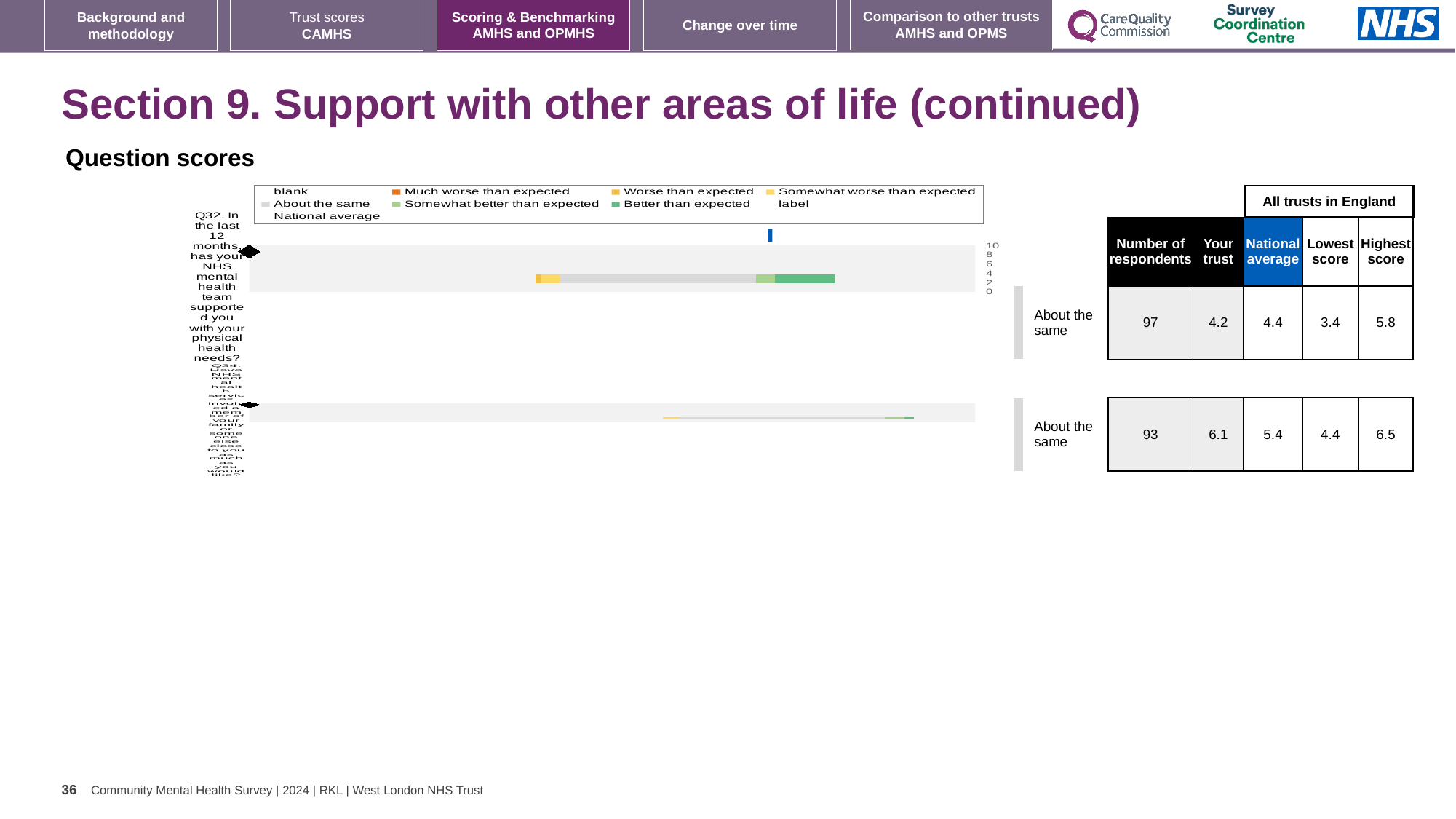
How many questions (categories) are plotted in the question scores chart? 2 What is the national average score for Q34 in the table beside the chart? 5.4 How many respondents answered Q32 according to the table beside the chart? 97 How many entries does the legend of the question scores chart list? 9 What is the 'Your trust' score for Q32 in the table beside the chart? 4.2 What is the highest score among all trusts in England for Q34? 6.5 In the question scores chart legend, what colour represents 'Better than expected'? green For Q34, which is larger: the 'Your trust' score or the national average? Your trust What is the lowest score among all trusts in England for Q32? 3.4 What is the difference between the 'Your trust' score and the national average for Q34? 0.7 What kind of chart is used to show the question scores on this slide? bar chart In the question scores chart legend, what colour represents 'About the same'? grey